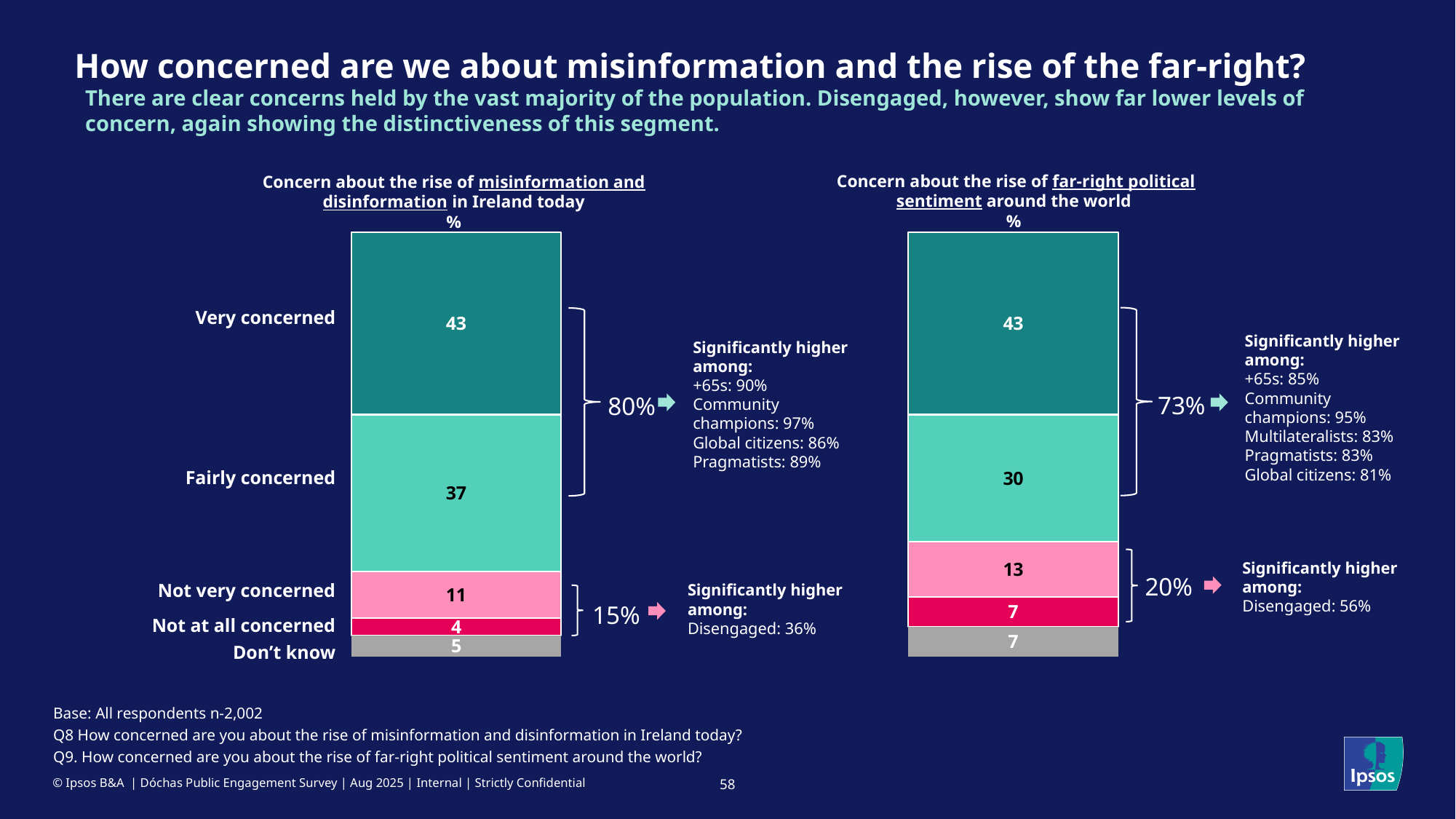
Is the 'Fairly concerned' share larger in the misinformation chart or in the far-right political sentiment chart? Misinformation chart In the chart on concern about the rise of misinformation and disinformation in Ireland today, what percentage are 'Very concerned'? 43 In the chart on concern about the rise of misinformation and disinformation in Ireland today, which response category has the smallest share? Not at all concerned In the chart on concern about the rise of far-right political sentiment around the world, what percentage are 'Fairly concerned'? 30 How many response categories are shown in each stacked bar on the slide? 5 What type of chart is used to show the concern levels on this slide? Stacked bar chart In the chart on concern about the rise of far-right political sentiment around the world, what is the difference between 'Very concerned' and 'Fairly concerned'? 13 In the chart on concern about the rise of far-right political sentiment around the world, what is the combined percentage of 'Not very concerned' and 'Not at all concerned' shown next to the bracket? 20% In the chart on concern about the rise of far-right political sentiment around the world, what percentage are 'Not at all concerned'? 7 In the chart on concern about the rise of misinformation and disinformation in Ireland today, what percentage answered 'Don't know'? 5 In the chart on concern about the rise of misinformation and disinformation in Ireland today, what is the combined percentage of 'Very concerned' and 'Fairly concerned' shown next to the bracket? 80% In the chart on concern about the rise of misinformation and disinformation in Ireland today, which response category has the largest share? Very concerned